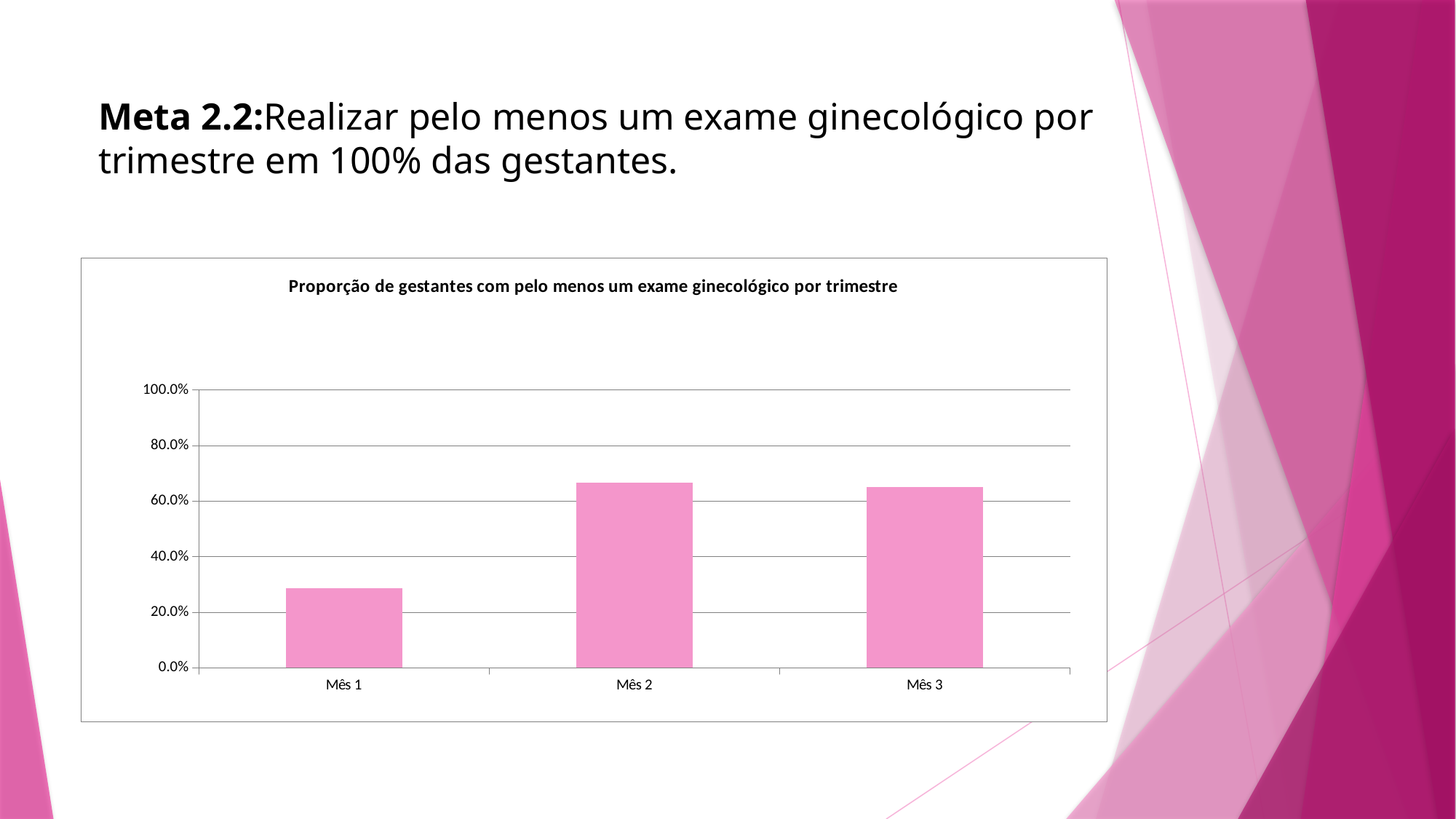
Is the value for Mês 1 greater or less than 20.0%? greater Is the value for Mês 2 greater or less than 60.0%? greater How many categories are shown on the x axis of the chart? 3 What is the title of the chart? Proporção de gestantes com pelo menos um exame ginecológico por trimestre What is the highest value shown on the y axis of the chart? 100.0% Is the value for Mês 3 greater or less than 60.0%? greater Which category has the lowest value in the chart? Mês 1 Which is larger, the value for Mês 1 or the value for Mês 2? Mês 2 What kind of chart is shown on the slide? bar chart